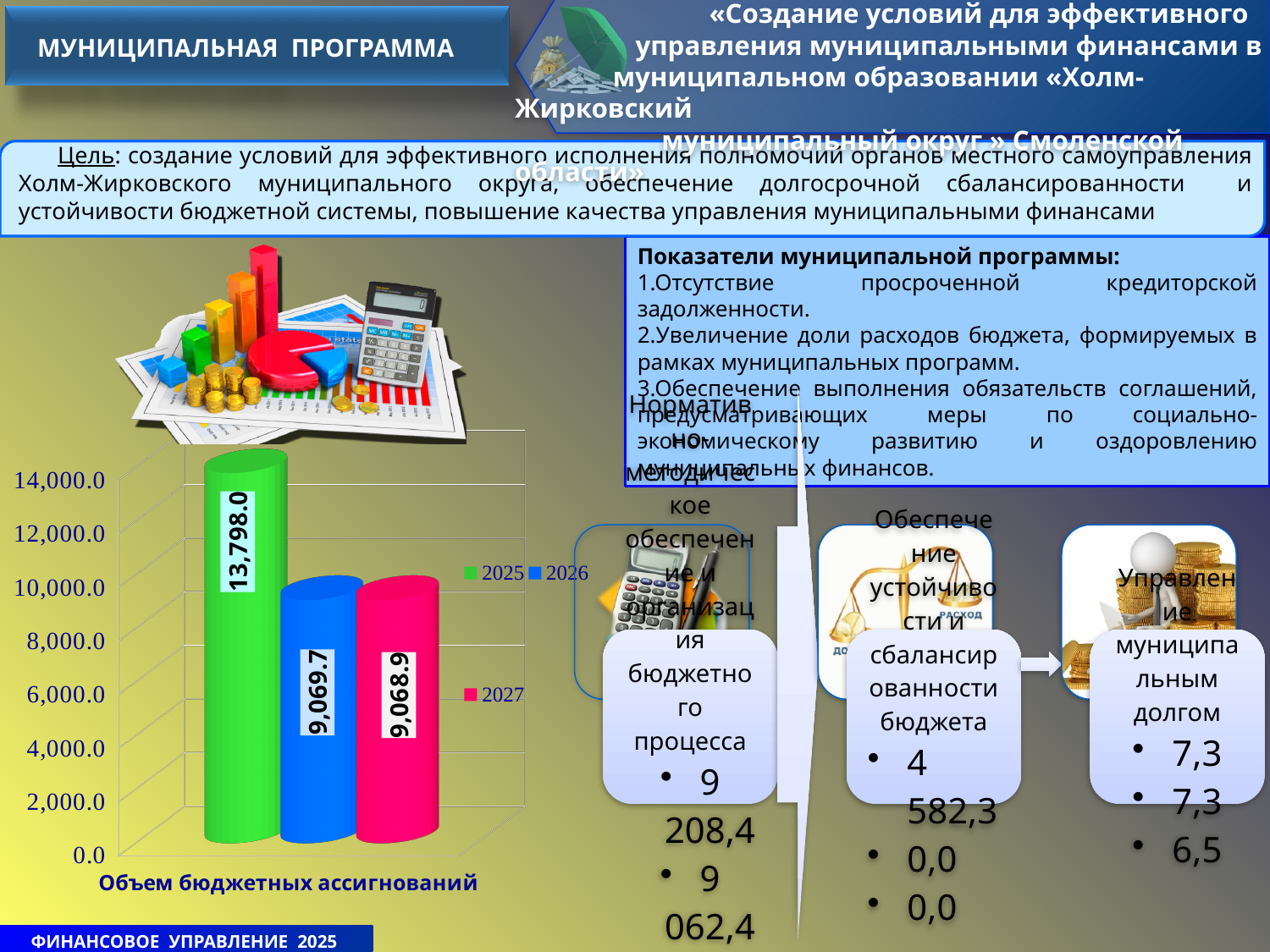
Which is larger, the value for 2025 or the value for 2027? 2025 Which year has the highest value in the chart? 2025 Is the value for 2026 greater or less than 10,000.0? less What is the difference between the values for 2025 and 2026? 4,728.3 What type of chart is shown on the slide? bar chart Is the value for 2025 greater or less than 12,000.0? greater What is the value for 2027 in the chart? 9,068.9 What is the value for 2026 in the chart? 9,069.7 How many series does the chart legend list? 3 What is the value for 2025 in the chart? 13,798.0 What is the difference between the values for 2026 and 2027? 0.8 What is the category label shown below the chart? Объем бюджетных ассигнований